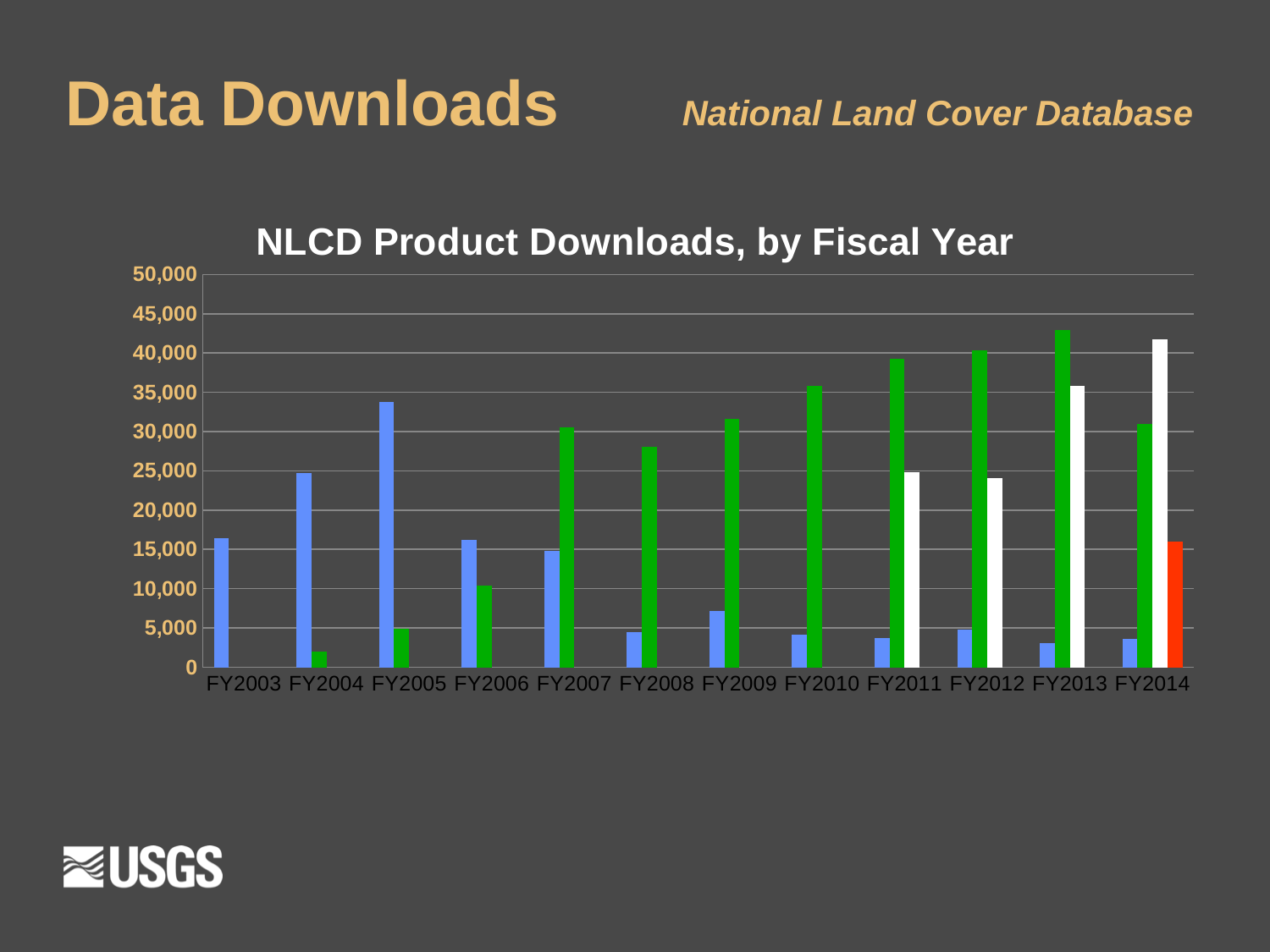
Is the value of the red bar for FY2014 greater or less than 20,000? less Do the green bars rise or fall from FY2008 to FY2013? rise In FY2014, which bar is taller, the white bar or the green bar? the white bar Which fiscal year is the only one with a red bar? FY2014 What type of chart is shown on the slide? bar chart How many bars are plotted for FY2014? 4 Which fiscal year has the tallest green bar? FY2013 Which fiscal year has the tallest blue bar? FY2005 What is the title of the chart? NLCD Product Downloads, by Fiscal Year How many fiscal years are shown on the x axis of the chart? 12 Is the value of the blue bar for FY2005 greater or less than 30,000? greater Is the value of the green bar for FY2013 greater or less than 40,000? greater